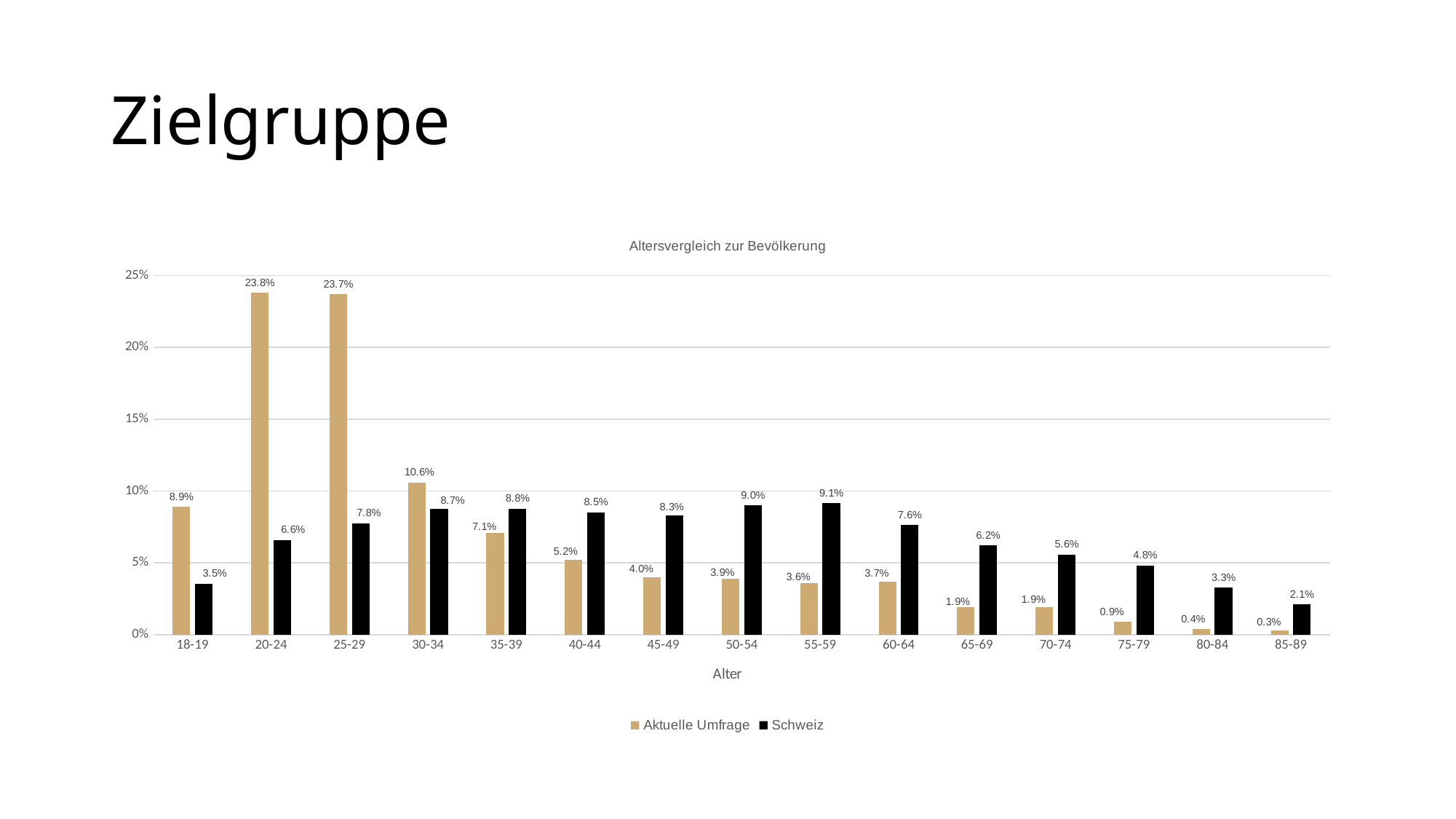
How many series does the legend list? 2 What is the value for Aktuelle Umfrage in the 20-24 age group? 23.8% What is the title of the chart? Altersvergleich zur Bevölkerung What is the value for Schweiz in the 55-59 age group? 9.1% What kind of chart is shown on the slide? Bar chart What is the difference between Aktuelle Umfrage and Schweiz in the 25-29 age group? 15.9% How many age groups are shown on the x axis? 15 Which age group has the highest value for Aktuelle Umfrage? 20-24 Which age group has the lowest value for Schweiz? 85-89 Is the value for Aktuelle Umfrage in the 30-34 age group greater or less than 10%? greater Do the Aktuelle Umfrage values rise or fall from the 30-34 age group to the 85-89 age group? Fall In the 60-64 age group, which series has the larger value, Aktuelle Umfrage or Schweiz? Schweiz